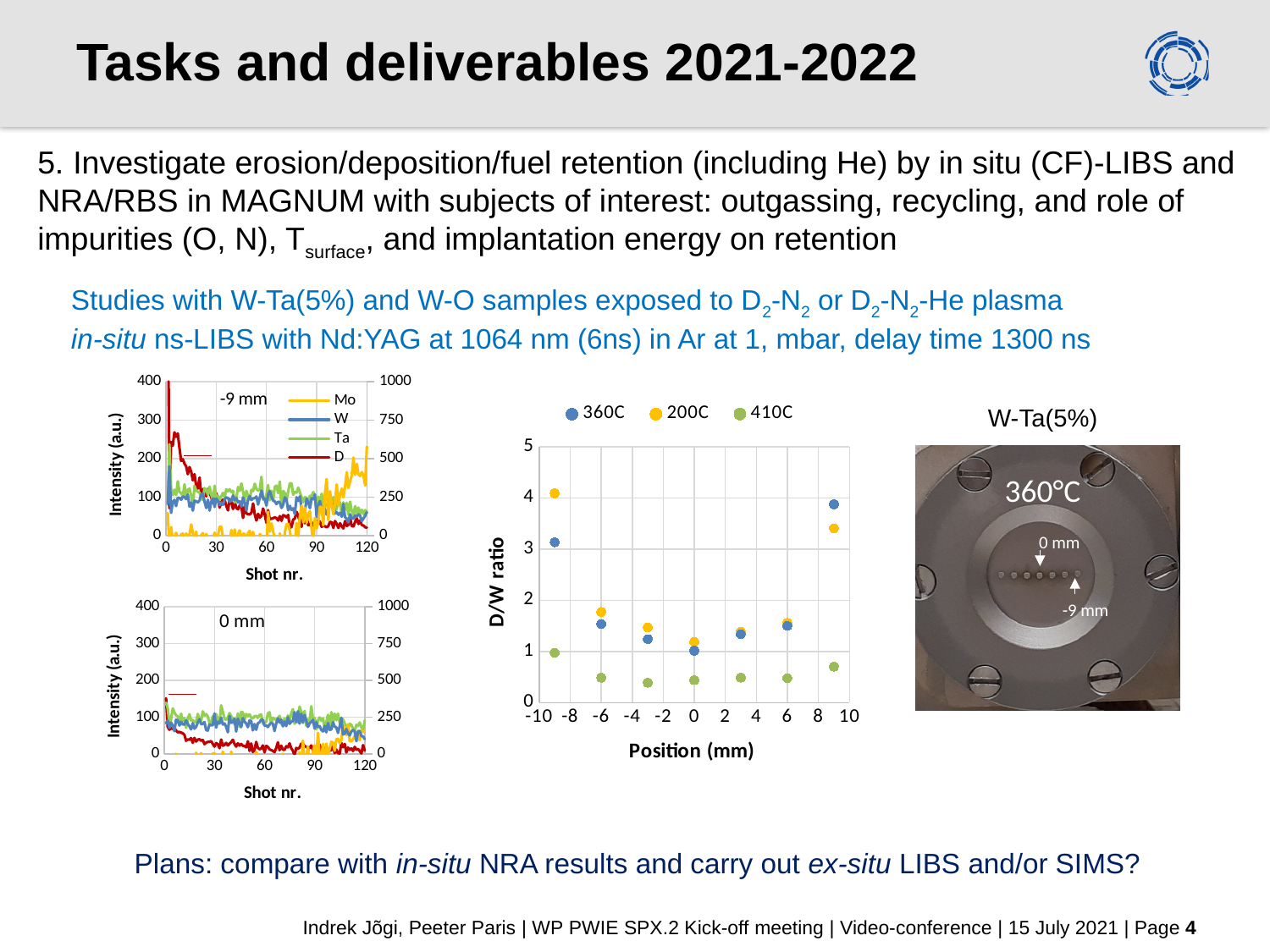
In the D/W ratio chart, is the 200C value at position -9 mm greater or less than 3? greater What kind of chart is the D/W ratio chart? scatter chart In the D/W ratio chart, which series has the lowest values across all positions? 410C In the D/W ratio chart, which series has the higher value at position -9 mm, 200C or 360C? 200C In the D/W ratio chart, what are the three series named in the legend? 360C, 200C, 410C In the D/W ratio chart, how many positions are plotted for each series? 7 In the 0 mm intensity chart (bottom left), does the D series rise or fall along the shot number axis? fall In the -9 mm intensity chart (top left), how many series does the legend list? 4 In the D/W ratio chart, what is the label of the x axis? Position (mm) In the D/W ratio chart, is the 360C value at position 9 mm greater or less than 3? greater In the D/W ratio chart, how many series does the legend list? 3 In the D/W ratio chart, is the 410C value at position 9 mm greater or less than 1? less